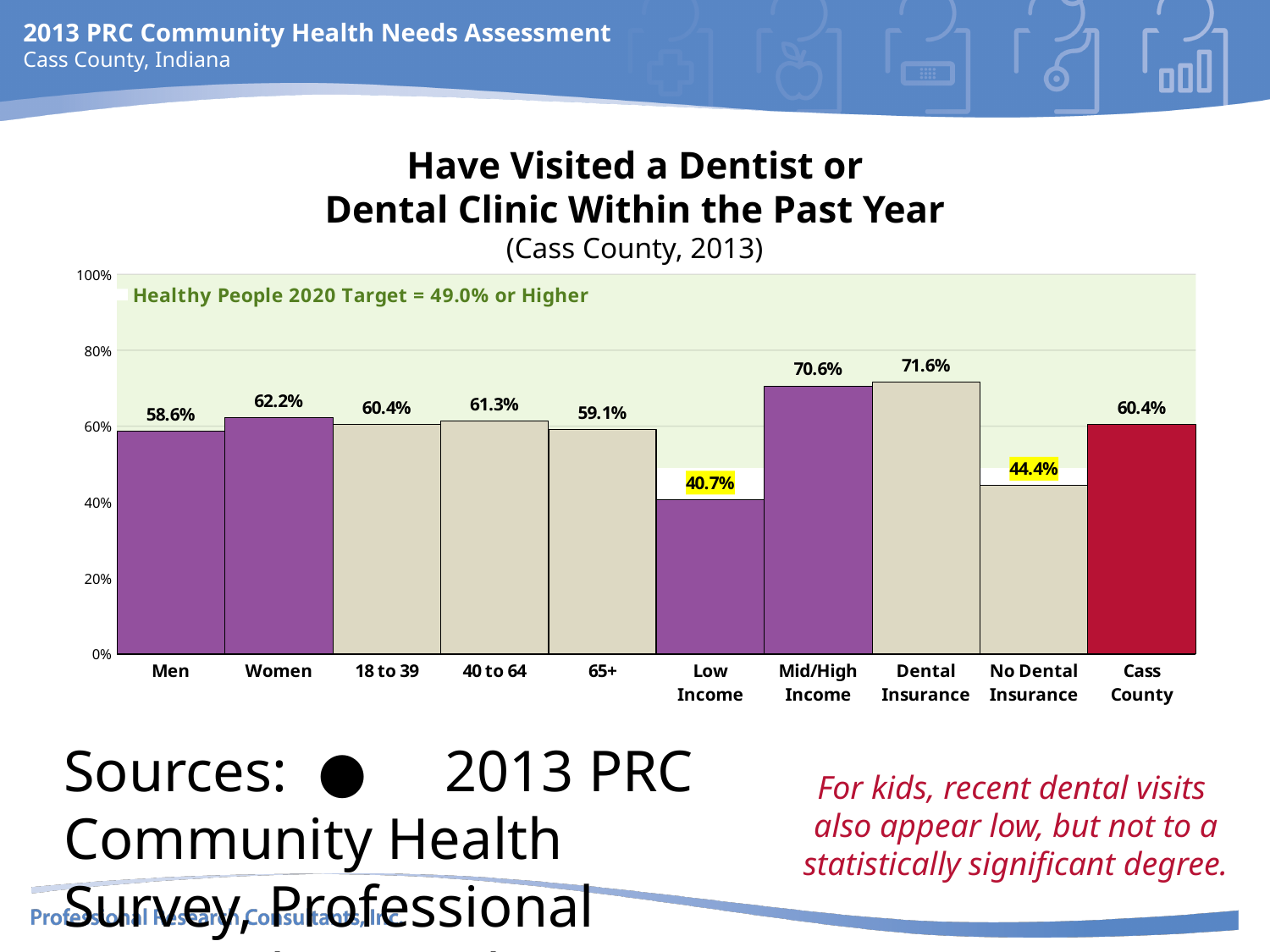
What kind of chart is this? bar chart What is the difference between the values for Mid/High Income and Low Income? 29.9% Is the value for Low Income greater or less than 60%? less What is the Healthy People 2020 Target shown on the chart? 49.0% or Higher What is the value for No Dental Insurance? 44.4% Which category has the lowest value? Low Income Which is larger, the value for Women or the value for Men? Women Which category has the highest value? Dental Insurance How many categories are shown on the x axis? 10 What is the value for Cass County? 60.4% What is the value for Men? 58.6% What is the difference between the values for Dental Insurance and No Dental Insurance? 27.2%